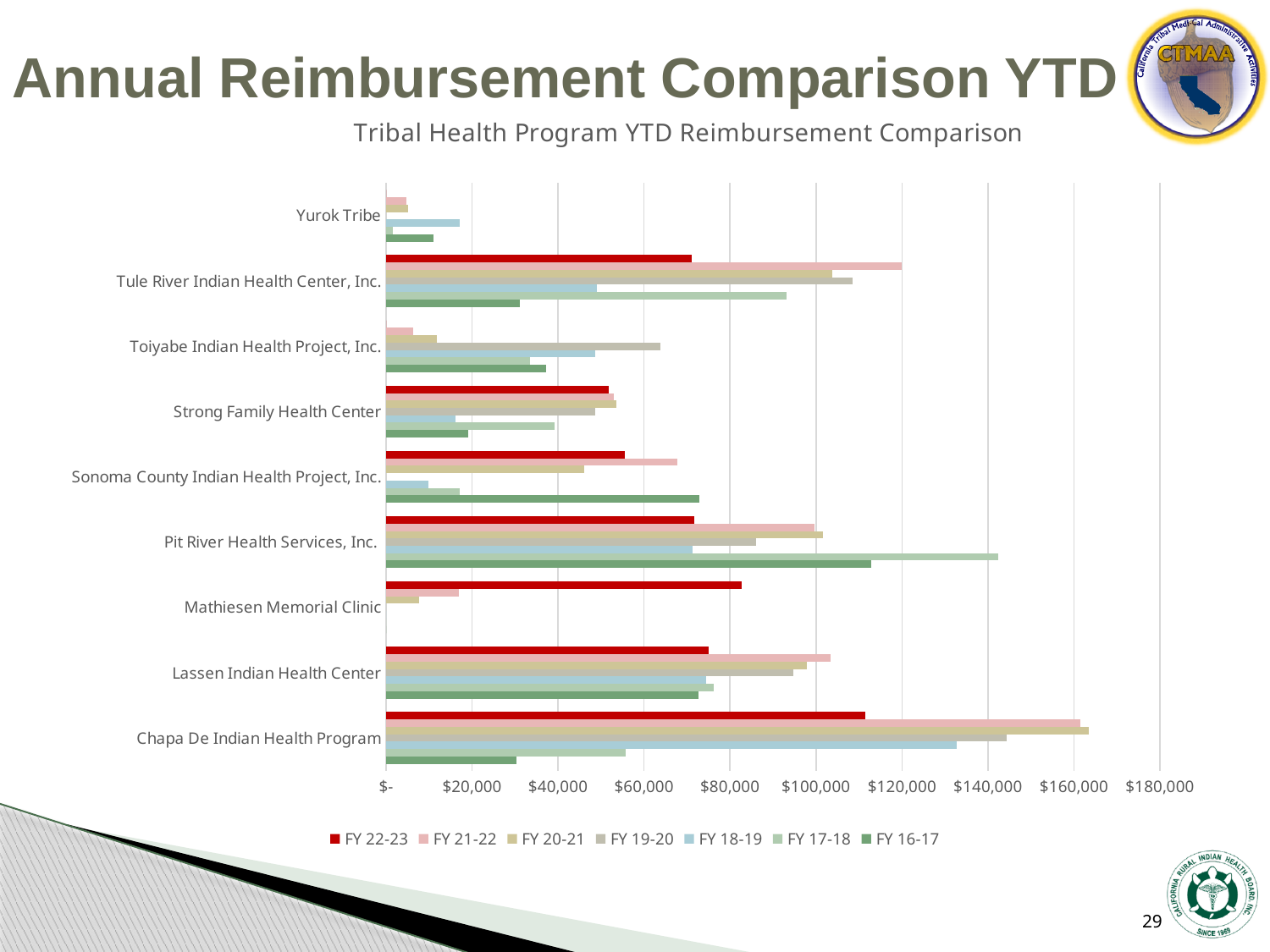
What kind of chart is shown on the slide? Bar chart Is the FY 22-23 value for Chapa De Indian Health Program greater or less than $100,000? greater How many tribal health programs are listed on the chart's vertical axis? 9 Is the FY 17-18 value for Pit River Health Services, Inc. greater or less than $120,000? greater Is the FY 18-19 value for Yurok Tribe greater or less than $20,000? less For Toiyabe Indian Health Project, Inc., which is larger: the FY 19-20 value or the FY 18-19 value? FY 19-20 What is the title of the chart? Tribal Health Program YTD Reimbursement Comparison Which program has the highest FY 22-23 reimbursement? Chapa De Indian Health Program How many fiscal-year series does the legend list? 7 For Mathiesen Memorial Clinic, which is larger: the FY 22-23 value or the FY 21-22 value? FY 22-23